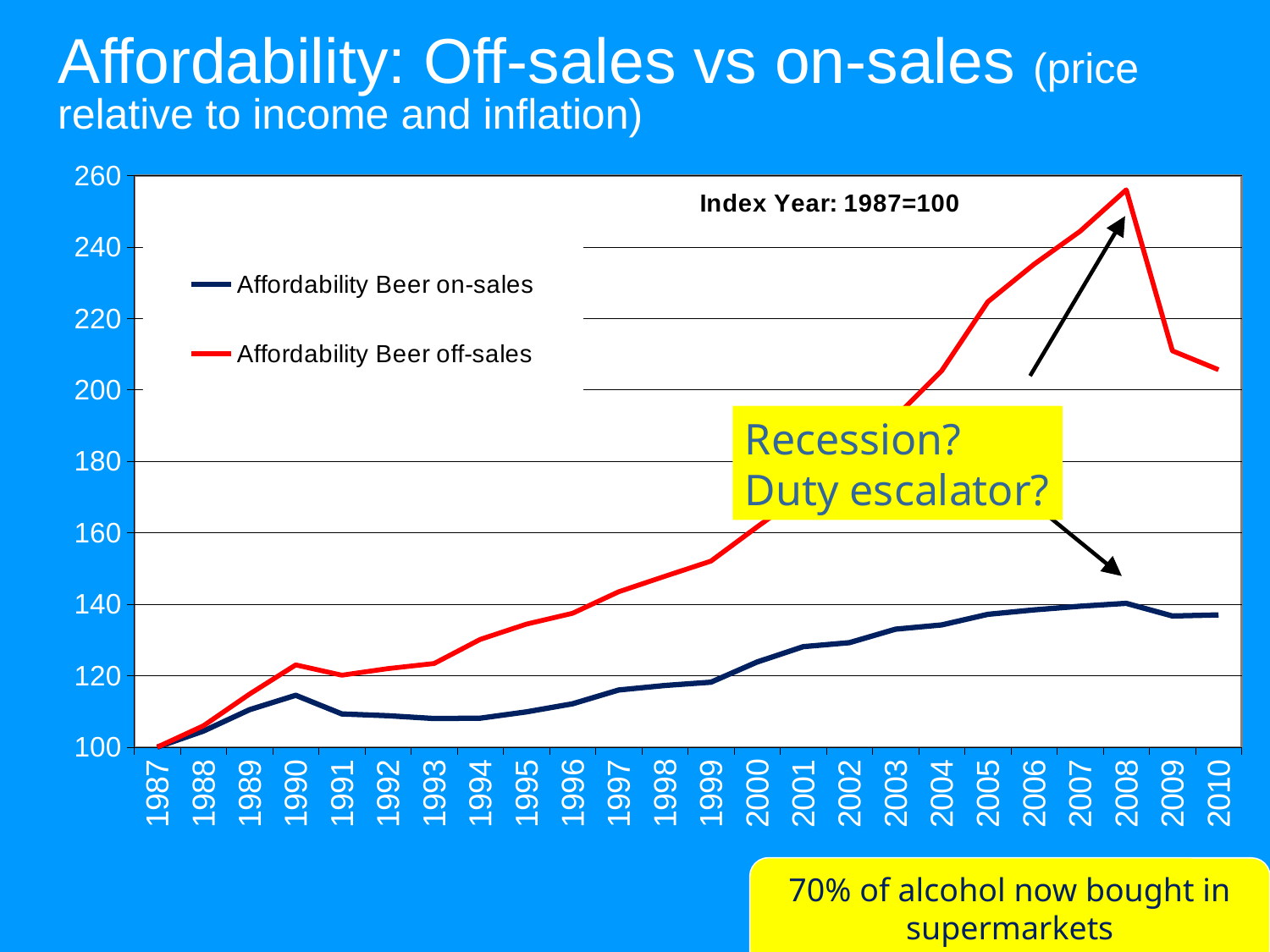
How many years are shown along the x axis? 24 In 2008, which series has the larger value: Affordability Beer on-sales or Affordability Beer off-sales? Affordability Beer off-sales Is the value for Affordability Beer off-sales in 2008 greater or less than 240? greater Is the value for Affordability Beer on-sales in 2008 greater or less than 160? less In which year does the Affordability Beer off-sales line reach its highest value? 2008 Does the Affordability Beer off-sales line rise or fall between 2008 and 2010? fall Is the value for Affordability Beer off-sales in 2010 greater or less than 180? greater In which year is the Affordability Beer on-sales line at its lowest value? 1987 What colour is the Affordability Beer off-sales line? red What is the index value for both series in 1987? 100 How many series does the legend list? 2 What kind of chart is shown on the slide? line chart